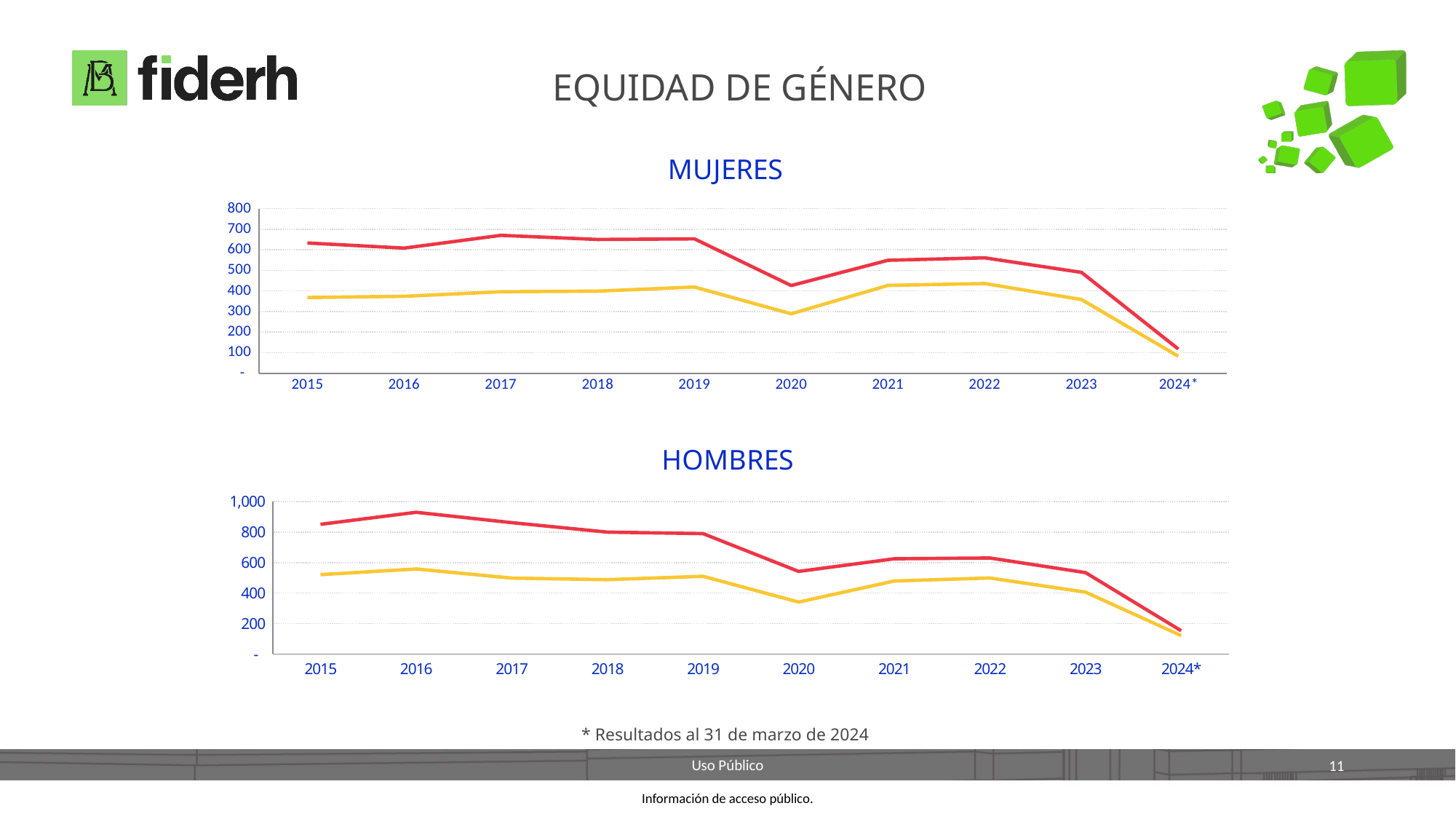
How many years are shown on the x axis of the HOMBRES chart? 10 In the HOMBRES chart, is the value of the red line for 2020 greater or less than 600? less What is the highest tick label on the y axis of the HOMBRES chart? 1,000 In the MUJERES chart, which year has the lowest value on the red line? 2024* In the HOMBRES chart, does the red line rise or fall from 2019 to 2020? fall In the MUJERES chart, is the value of the red line for 2017 greater or less than 600? greater In the MUJERES chart, is the value of the yellow line for 2020 greater or less than 400? less In the MUJERES chart, is the red line higher in 2019 or in 2020? 2019 What kind of chart is the MUJERES chart? Line chart In the HOMBRES chart, which year has the highest value on the red line? 2016 How many years are shown on the x axis of the MUJERES chart? 10